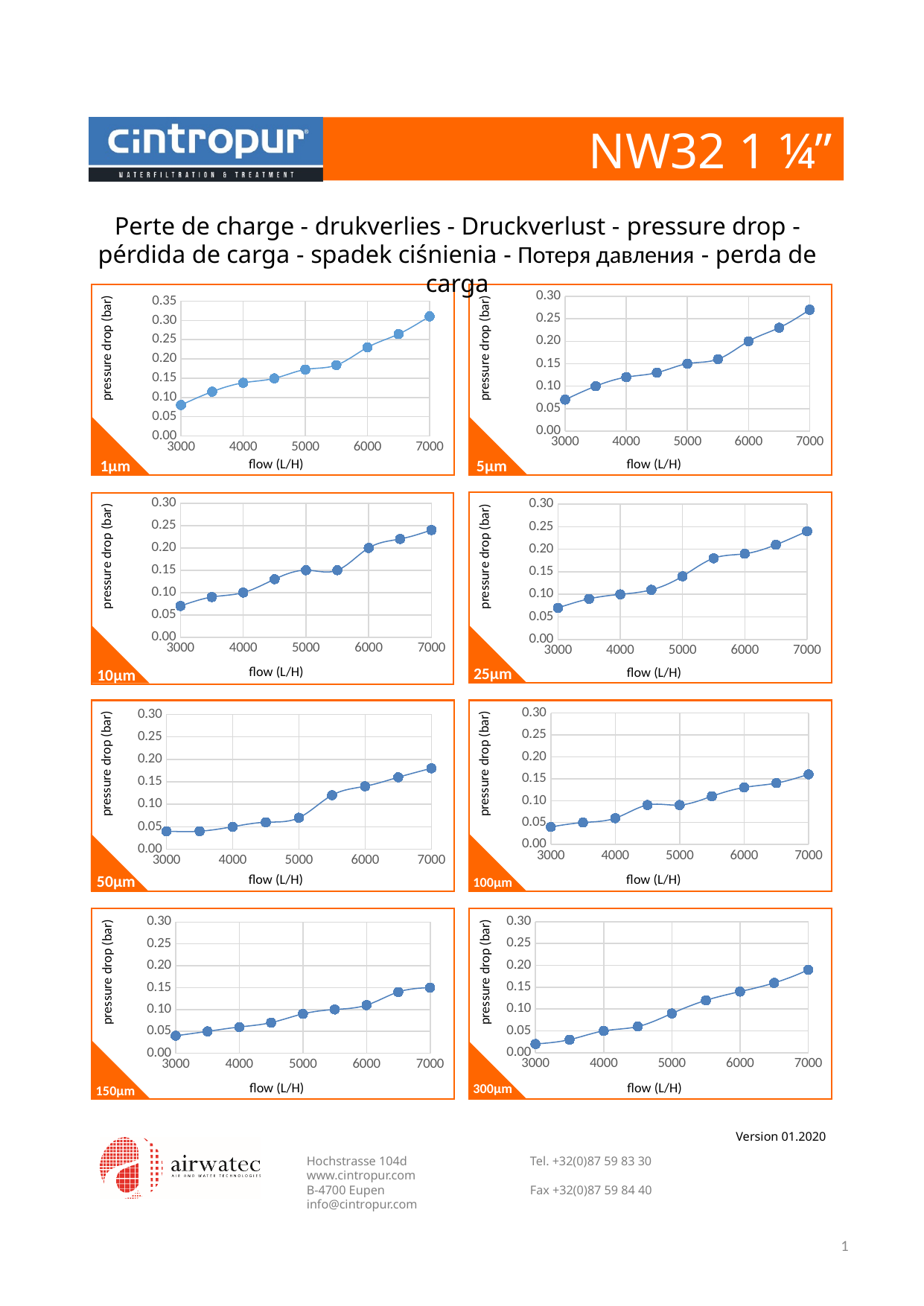
In the 10µm chart, at which flow is the pressure drop highest? 7000 What is the x-axis label on the 25µm chart? flow (L/H) How many data points are plotted in the 5µm chart? 9 In the 50µm chart, is the pressure drop at 7000 L/H greater or less than 0.20 bar? less What kind of chart is the 1µm chart? line chart In the 300µm chart, is the pressure drop at 3000 L/H greater or less than 0.05 bar? less In the 150µm chart, what is the pressure drop at 7000 L/H? 0.15 In the 1µm chart, does the pressure drop rise or fall as flow increases from 3000 to 7000 L/H? rise In the 10µm chart, what is the pressure drop at 5000 L/H? 0.15 In the 5µm chart, what is the pressure drop at 6000 L/H? 0.20